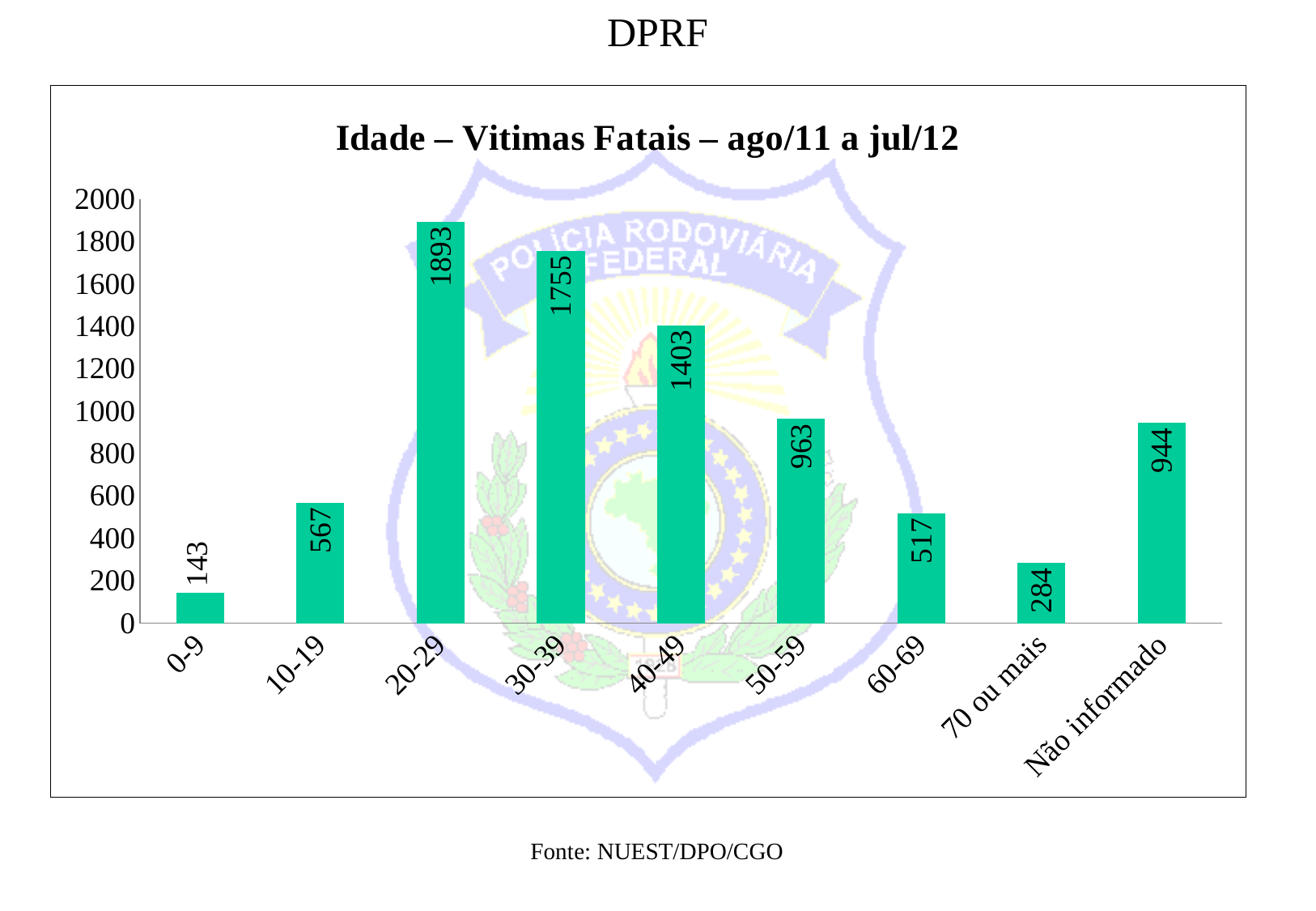
Which category has the lowest value? 0-9 Is the value for 40-49 greater or less than 1200? greater Which is larger, the value for 50-59 or the value for 'Não informado'? 50-59 What is the difference between the values for 10-19 and 60-69? 50 How many categories are shown on the x axis? 9 What is the title of the chart? Idade – Vitimas Fatais – ago/11 a jul/12 Which age category has the highest value? 20-29 What is the value for the 20-29 age group? 1893 What is the value for the 'Não informado' category? 944 What kind of chart is shown on the slide? bar chart What is the difference between the values for 20-29 and 30-39? 138 What is the value for the 70 ou mais age group? 284